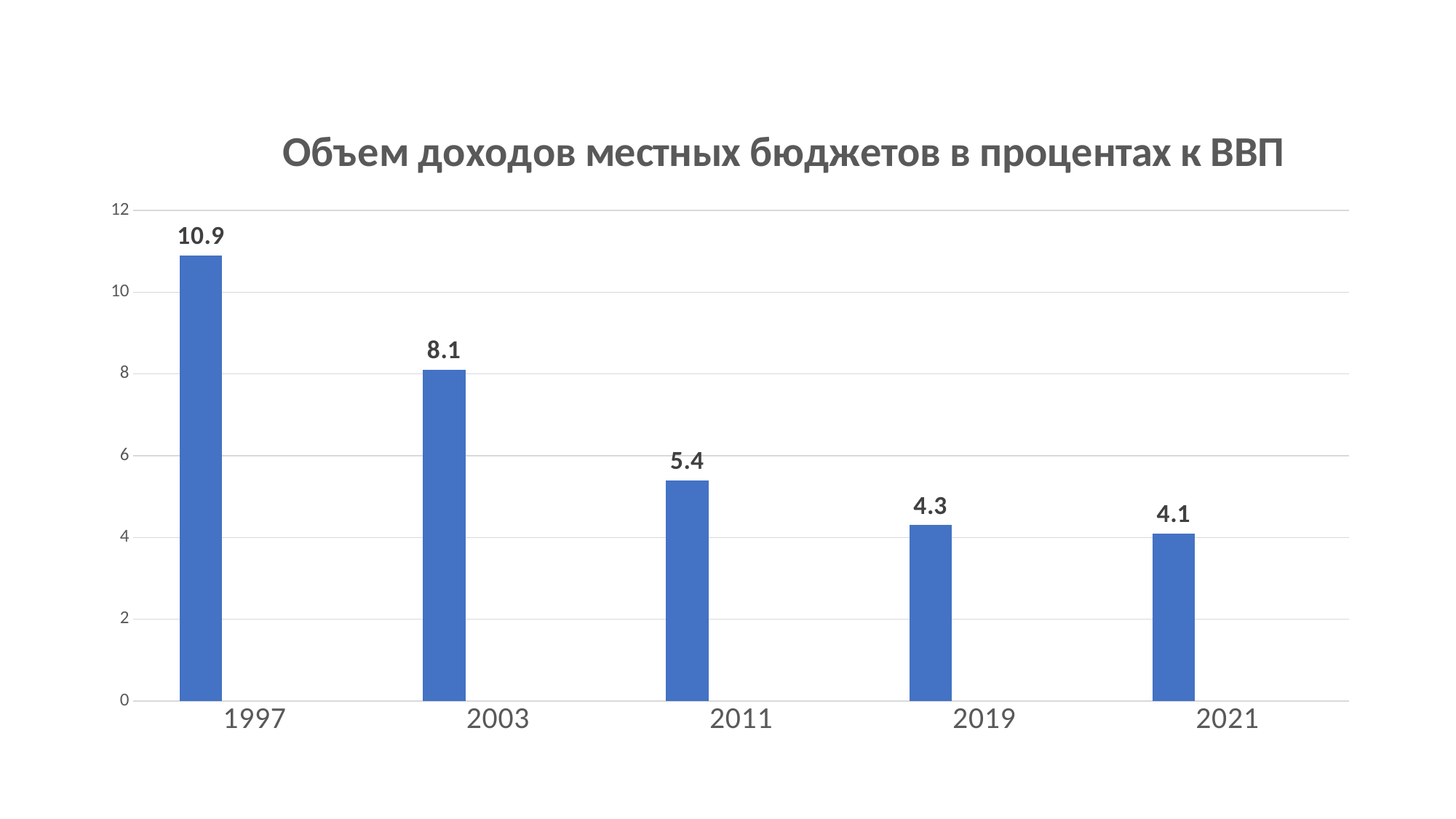
What is the difference between the values for 2011 and 2019? 1.1 How many years are shown on the x axis? 5 What is the value for 2011? 5.4 What is the value for 2021? 4.1 Which is larger, the value for 2003 or the value for 2011? 2003 Do the values rise or fall from 1997 to 2021? fall What kind of chart is this? bar chart Is the value for 2003 greater or less than 8? greater Which year has the lowest value? 2021 What is the difference between the values for 1997 and 2003? 2.8 What is the value for 1997? 10.9 Which year has the highest value? 1997